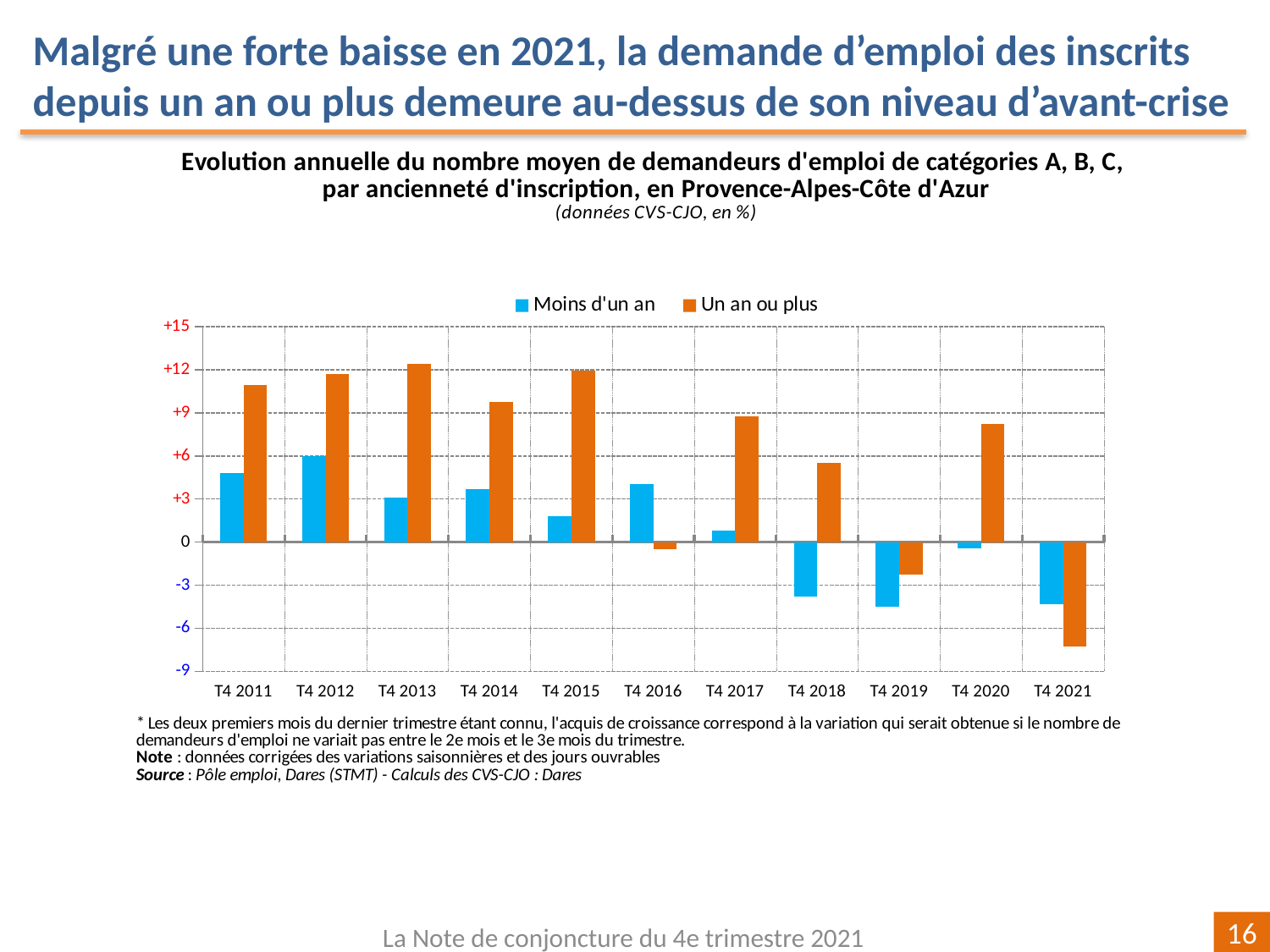
What kind of chart is shown on the slide? bar chart Is the 'Un an ou plus' value for T4 2011 greater or less than 9? greater How many quarters (categories) are shown on the x axis? 11 Which series is shown in orange? Un an ou plus Does the 'Moins d'un an' value rise or fall from T4 2016 to T4 2019? fall In T4 2016, which series has the larger value, 'Moins d'un an' or 'Un an ou plus'? Moins d'un an Is the 'Moins d'un an' value for T4 2018 greater or less than -3? less For which quarter is the 'Un an ou plus' value the lowest? T4 2021 Is the 'Un an ou plus' value for T4 2021 greater or less than -6? less How many series does the legend list? 2 For which quarter is the 'Moins d'un an' value the highest? T4 2012 What are the two series named in the legend? Moins d'un an; Un an ou plus